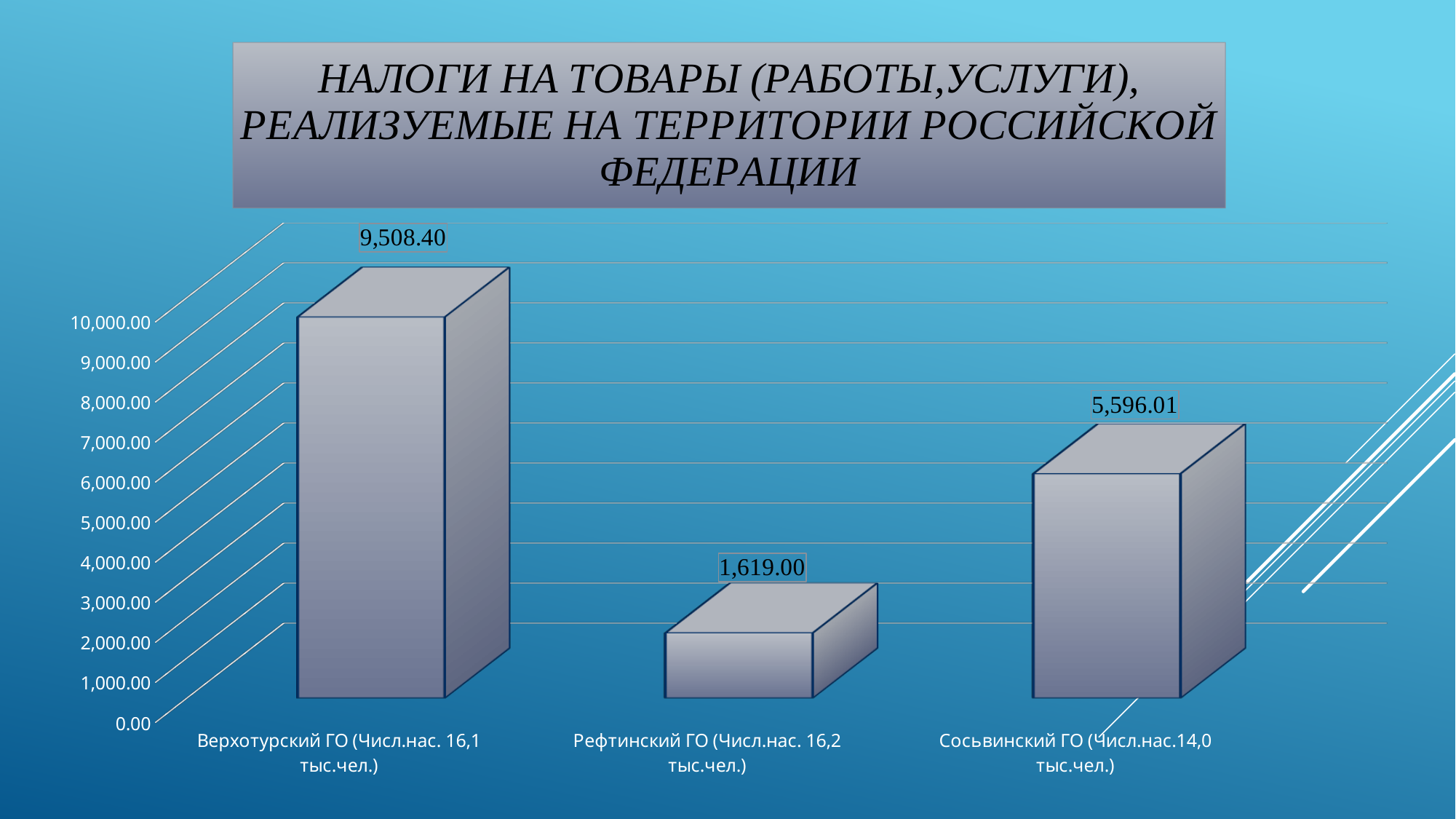
Which category has the lowest value? Рефтинский ГО Which is larger, the value for Сосьвинский ГО or the value for Рефтинский ГО? Сосьвинский ГО What kind of chart is shown on the slide? bar chart What is the difference between the values for Верхотурский ГО and Рефтинский ГО? 7,889.40 What is the value shown for Сосьвинский ГО? 5,596.01 How many categories are shown on the chart? 3 Which category has the highest value? Верхотурский ГО Is the value for Сосьвинский ГО greater or less than 5,000.00? greater What is the value shown for Рефтинский ГО? 1,619.00 What is the title of the chart? НАЛОГИ НА ТОВАРЫ (РАБОТЫ,УСЛУГИ), РЕАЛИЗУЕМЫЕ НА ТЕРРИТОРИИ РОССИЙСКОЙ ФЕДЕРАЦИИ What is the difference between the values for Верхотурский ГО and Сосьвинский ГО? 3,912.39 What is the value shown for Верхотурский ГО? 9,508.40